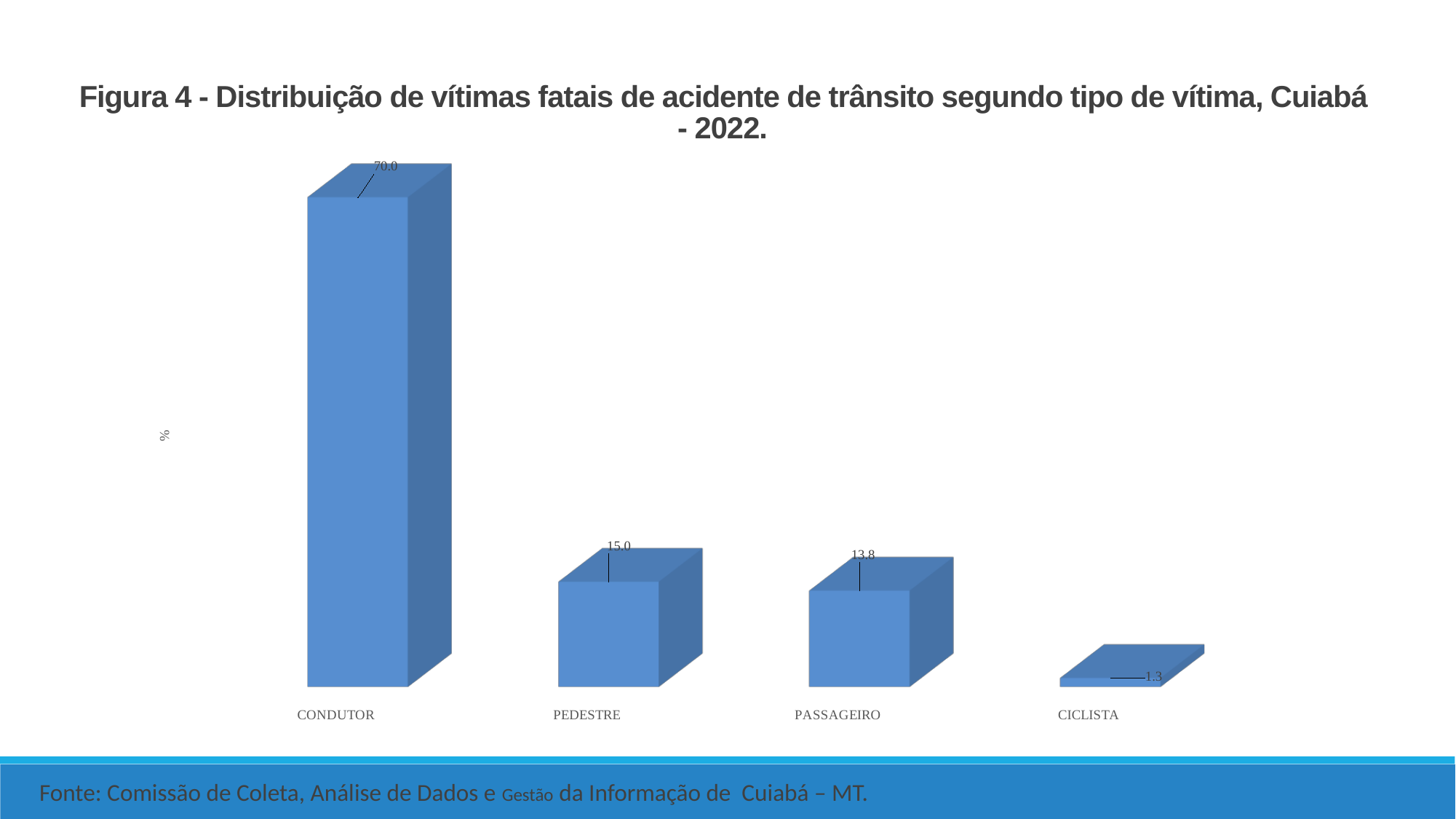
What is the value for PEDESTRE? 15.0 What is the value for PASSAGEIRO? 13.8 What is the value for CONDUTOR? 70.0 What is the difference between the values for CONDUTOR and PEDESTRE? 55.0 What kind of chart is shown on the slide? bar chart Which category has the lowest value? CICLISTA What is the label on the vertical axis? % Which category has the highest value? CONDUTOR How many categories are shown on the x axis? 4 What is the value for CICLISTA? 1.3 What is the difference between the values for PEDESTRE and PASSAGEIRO? 1.2 Which is larger, the value for PEDESTRE or the value for CICLISTA? PEDESTRE